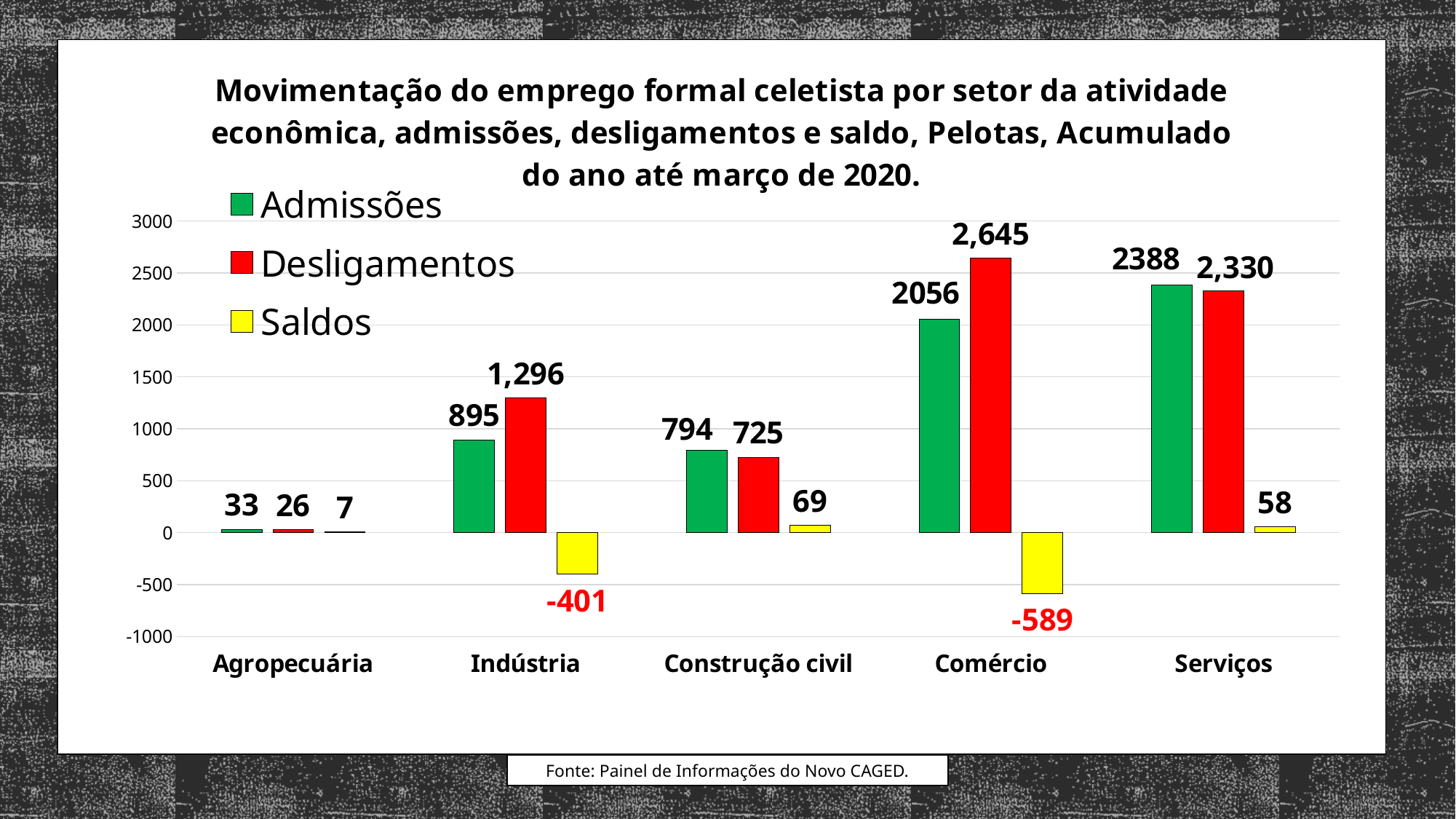
Which is larger for Construção civil, Admissões or Desligamentos? Admissões What is the Saldos value for Construção civil? 69 What is the Saldos value for Comércio? -589 Which sector has the highest Desligamentos value? Comércio How many sectors are shown on the x axis? 5 What is the difference between Desligamentos and Admissões for Serviços? 58 Which sector has the lowest Admissões value? Agropecuária What is the Admissões value for Comércio? 2056 What is the Desligamentos value for Indústria? 1,296 How many series does the legend list? 3 What colour represents the Saldos series in the legend? Yellow What kind of chart is shown on the slide? Bar chart